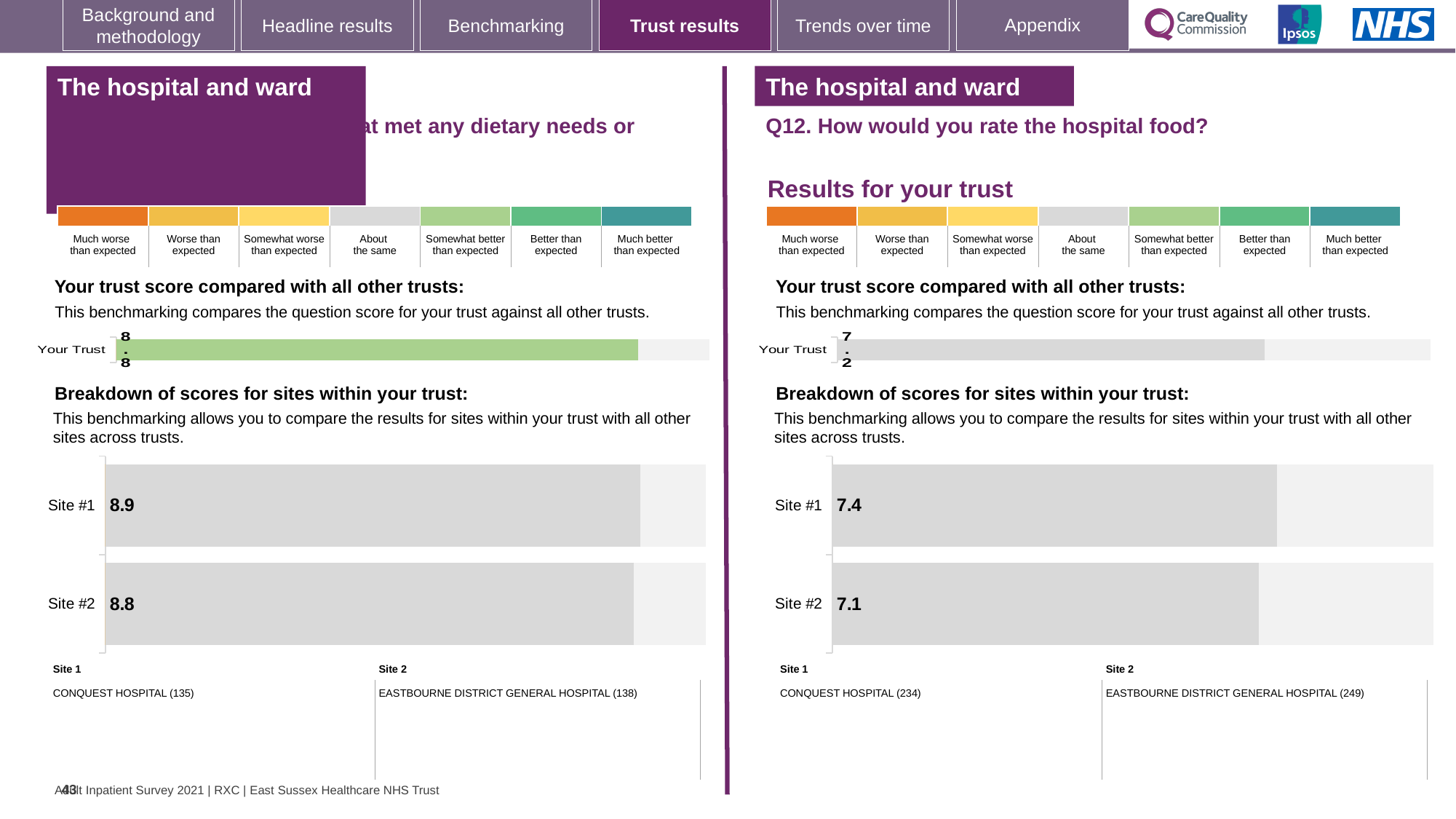
On the left-hand chart, what is the score for Site #2? 8.8 On the left-hand chart, what colour is the 'Your Trust' bar? Green On the right-hand chart (Q12. How would you rate the hospital food?), what is the 'Your Trust' score? 7.2 What type of chart is used to show the breakdown of scores for sites on the right-hand side of the slide? Bar chart On the right-hand chart (Q12. How would you rate the hospital food?), how many sites are shown in the breakdown of scores? 2 On the left-hand chart, what is the score for Site #1? 8.9 On the right-hand chart (Q12. How would you rate the hospital food?), what is the score for Site #2? 7.1 On the right-hand chart (Q12. How would you rate the hospital food?), which site has the higher score? Site #1 On the left-hand chart, what is the difference between the Site #1 and Site #2 scores? 0.1 On the right-hand chart (Q12. How would you rate the hospital food?), what is the score for Site #1? 7.4 On the right-hand chart (Q12. How would you rate the hospital food?), what is the difference between the Site #1 and Site #2 scores? 0.3 On the left-hand chart, what is the 'Your Trust' score? 8.8